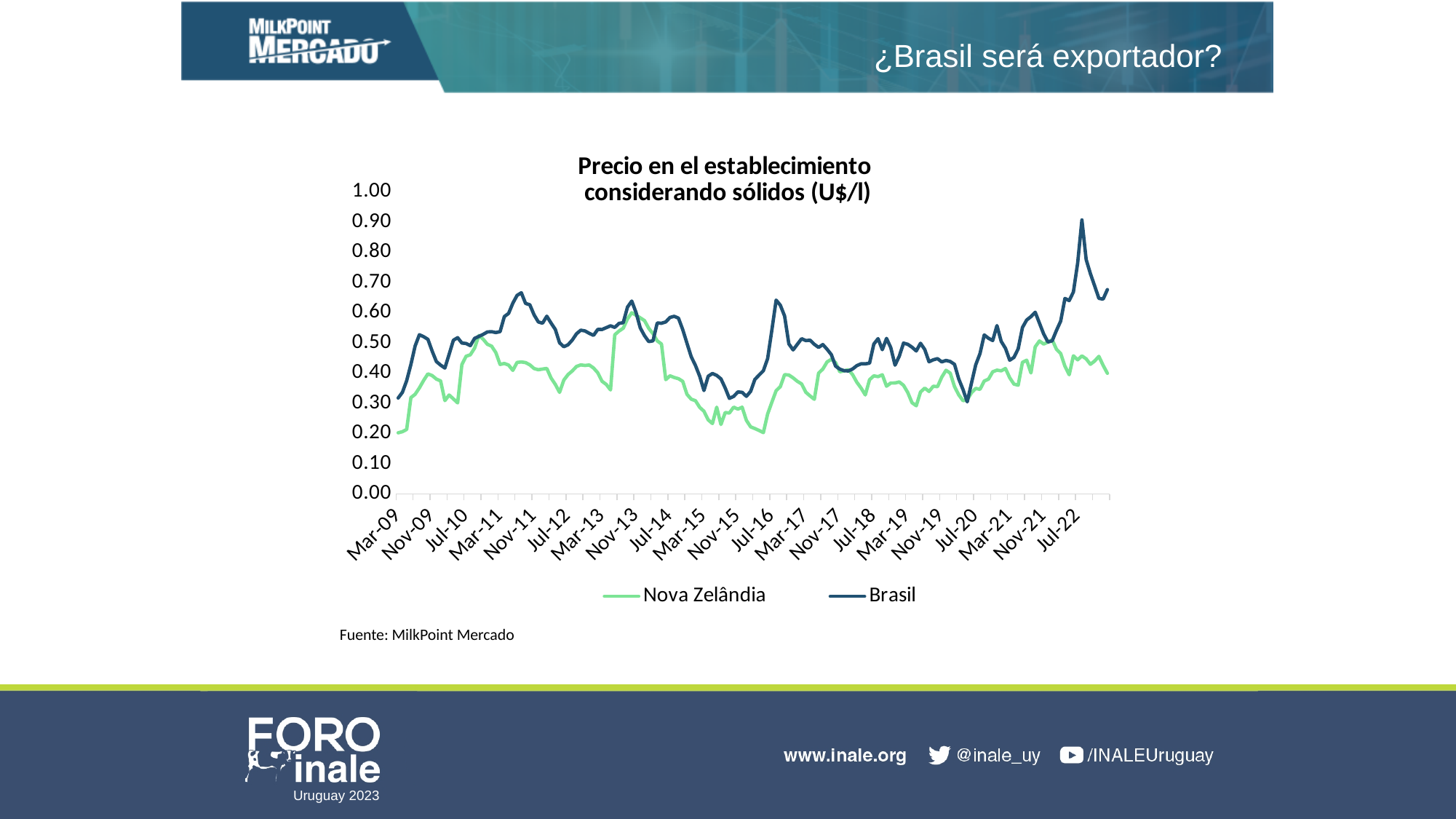
Which colour is used for the Brasil line? Dark blue What kind of chart is shown on the slide? Line chart What is the title of the chart? Precio en el establecimiento considerando sólidos (U$/l) Is the value for Brasil at Jul-16 greater or less than 0.50? greater How many date labels are shown on the x axis? 21 Is the peak value of the Brasil line in 2022 greater or less than 0.80? greater Which series reaches the lowest value anywhere on the chart? Nova Zelândia Is the value for Nova Zelândia at Mar-09 greater or less than 0.30? less Which series reaches the highest value anywhere on the chart? Brasil How many series does the legend list? 2 Does the Brasil line generally rise or fall between Jul-20 and Jul-22? rise At Jul-16, which series has the higher value, Brasil or Nova Zelândia? Brasil